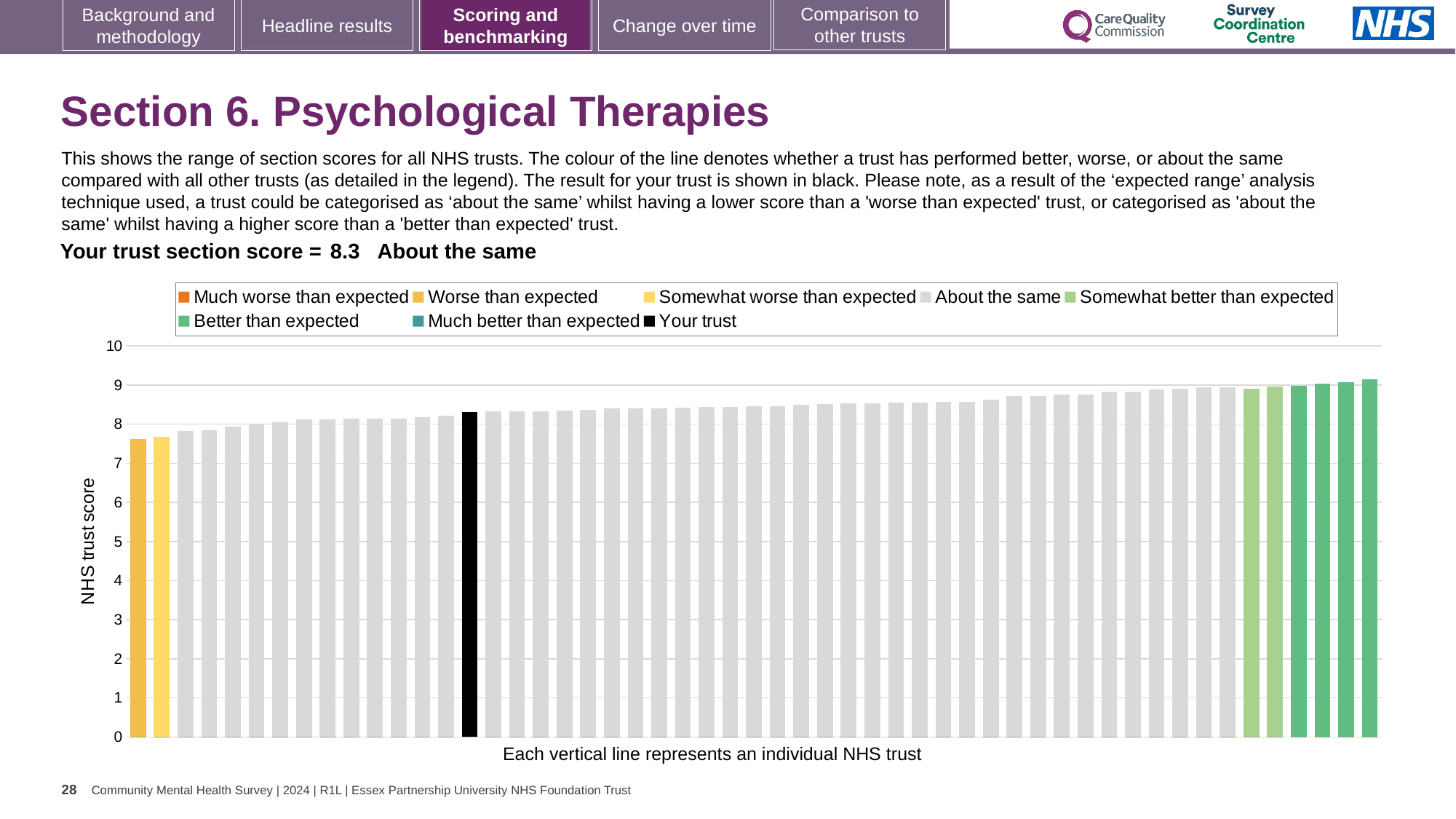
What kind of chart is used to show the range of section scores? Bar chart What is the section score for your trust shown on the slide? 8.3 How many bars on the chart are coloured yellow (worse or somewhat worse than expected)? 2 Do the trust scores rise or fall moving from left to right along the x axis? Rise How many entries does the chart legend list? 8 Is the value for the leftmost bar greater or less than 8? less Is the value for your trust (the black bar) greater or less than 8? greater Which performance category is your trust placed in for Section 6? About the same What is the label on the vertical axis of the chart? NHS trust score Is the highest trust score on the chart greater or less than 10? less What colour is used for the bar representing your trust? Black